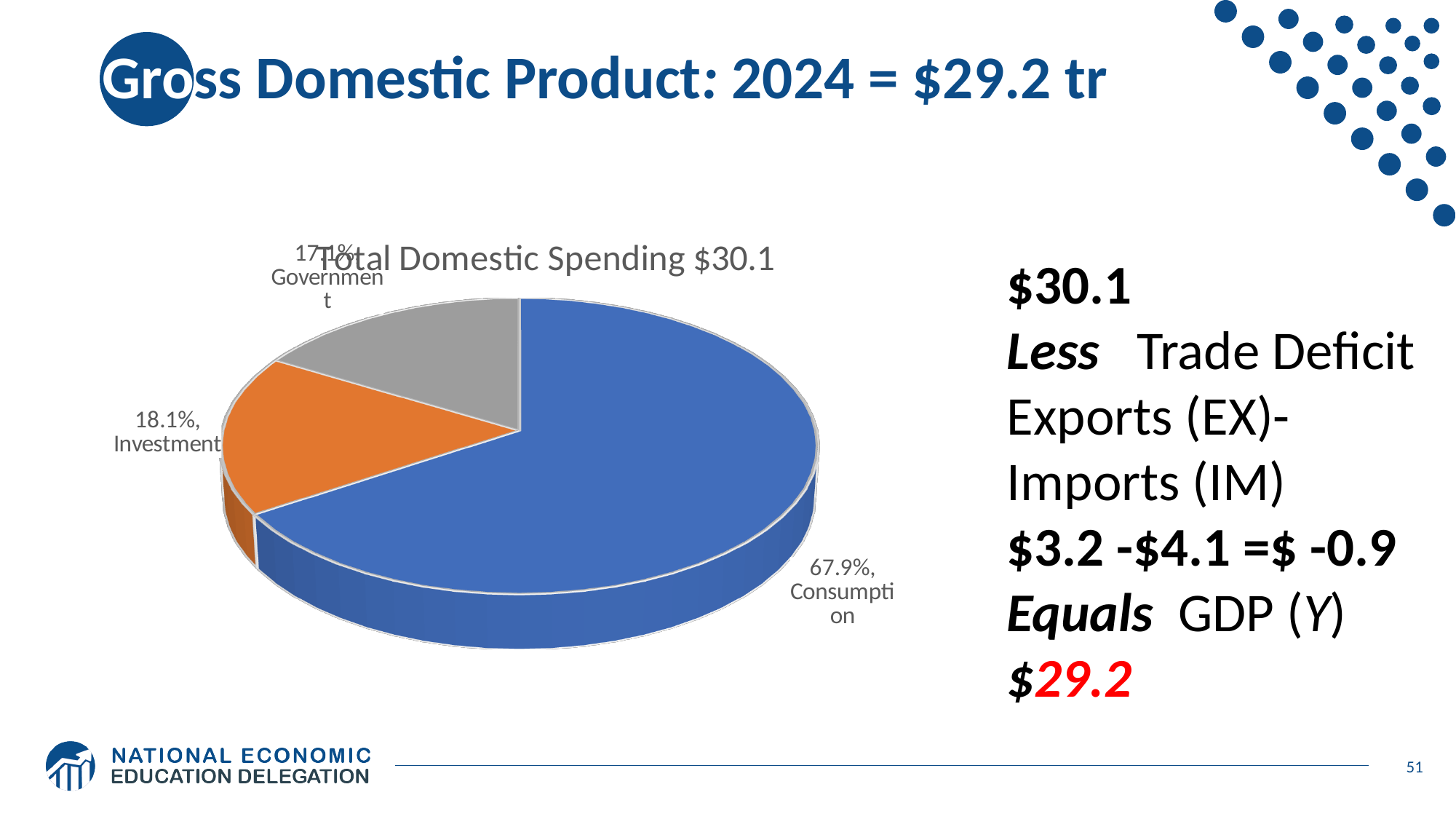
Is the Investment share greater or less than 25%? less Which category has the smallest slice of the pie? Government How many slices does the pie chart have? 3 What is the difference in percentage points between the Consumption share and the Investment share? 49.8% What is the title of the pie chart? Total Domestic Spending $30.1 Which is larger, the Investment slice or the Government slice? Investment What colour is the Consumption slice of the pie? Blue What share of total domestic spending is Investment? 18.1% What kind of chart is shown on the slide? Pie chart Which category has the largest slice of the pie? Consumption What share of total domestic spending is Consumption? 67.9% Is the Consumption share greater or less than 50%? greater